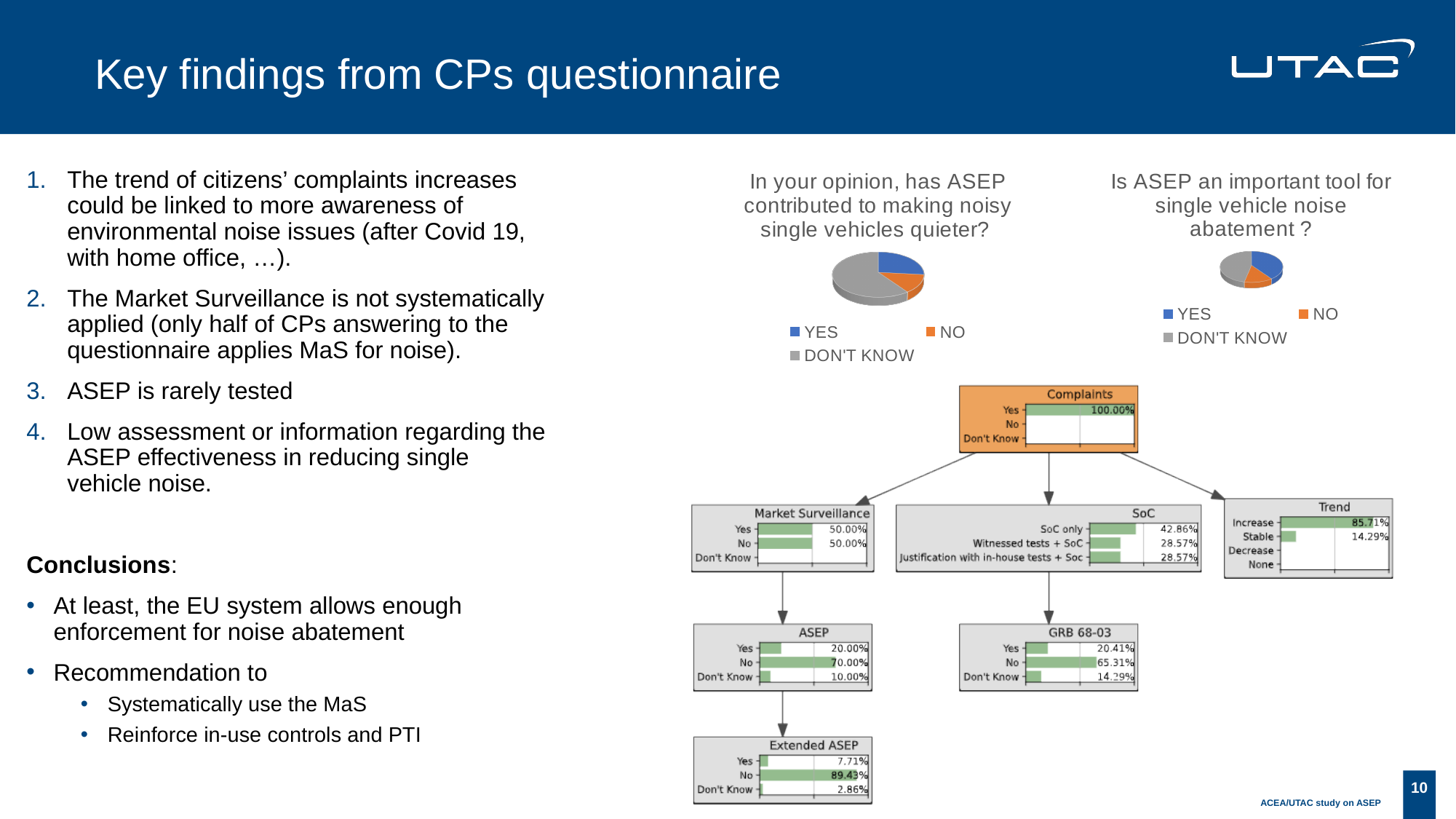
In the 'Complaints' chart, what is the value for 'Yes'? 100.00% In the pie chart titled 'In your opinion, has ASEP contributed to making noisy single vehicles quieter?', which slice is the largest? DON'T KNOW In the 'Trend' chart, what is the value for 'Increase'? 85.71% In the 'SoC' chart, which category has the highest value? SoC only In the 'ASEP' chart, what is the difference between the values for 'No' and 'Yes'? 50.00% How many categories does the 'SoC' chart show? 3 How many entries does the legend of the pie chart titled 'Is ASEP an important tool for single vehicle noise abatement ?' list? 3 In the 'GRB 68-03' chart, which is larger, the value for 'Yes' or the value for 'No'? No In the 'GRB 68-03' chart, which category has the lowest value? Don't Know In the 'Extended ASEP' chart, what is the value for 'Don't Know'? 2.86% In the 'Market Surveillance' chart, what is the value for 'Yes'? 50.00% In the 'ASEP' chart, what is the value for 'No'? 70.00%